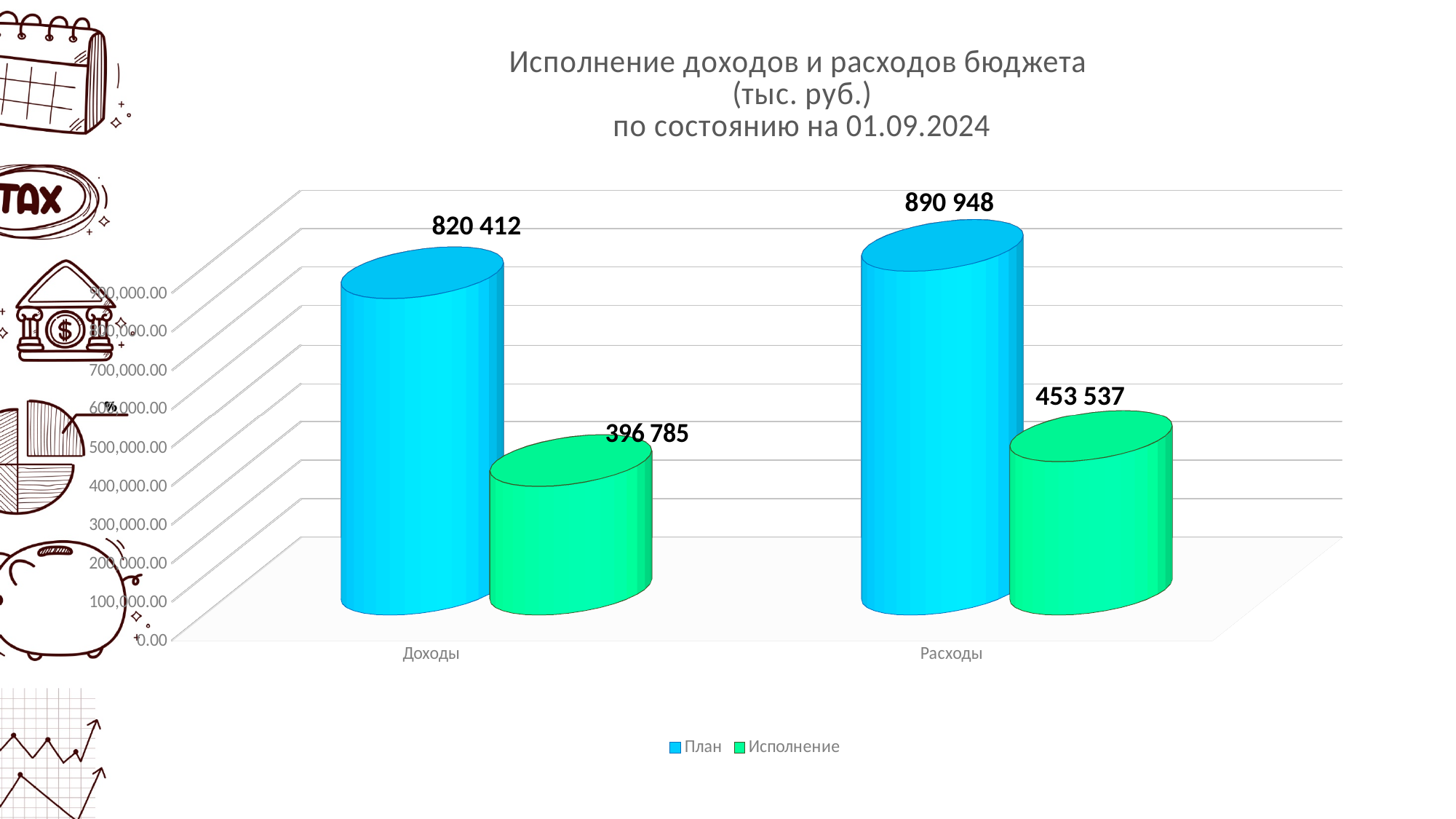
What is the План value for Расходы? 890 948 What is the Исполнение value for Доходы? 396 785 Which category has the highest План value? Расходы Which category has the lowest Исполнение value? Доходы What is the Исполнение value for Расходы? 453 537 What kind of chart is shown on the slide? Bar chart Which is larger: the Исполнение value for Расходы or the Исполнение value for Доходы? Расходы What is the План value for Доходы? 820 412 What is the difference between the План values for Расходы and Доходы? 70 536 How many categories are shown on the x axis? 2 How many series does the legend list? 2 What is the difference between the План and Исполнение values for Доходы? 423 627